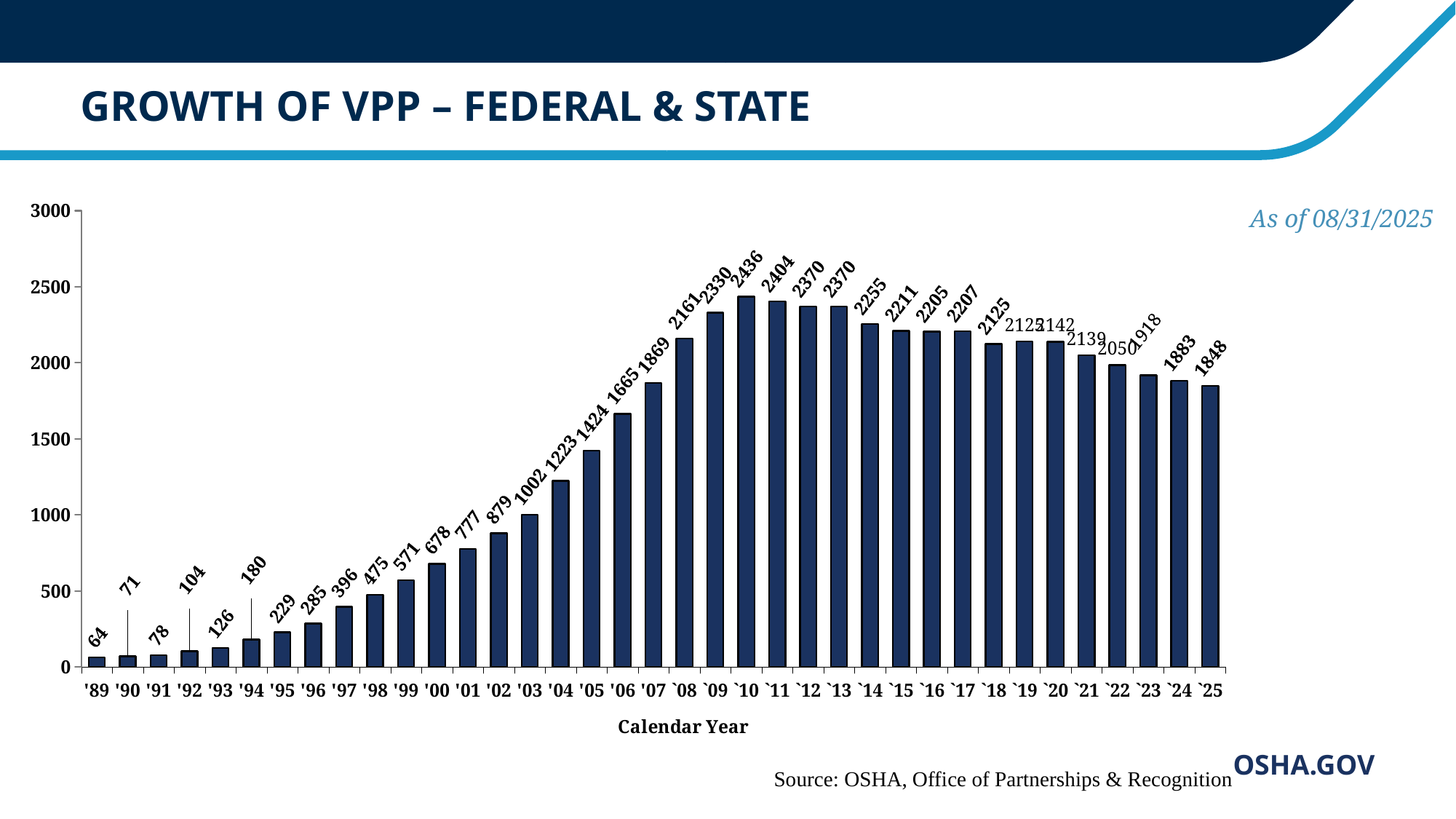
How many years are shown on the x axis? 37 Which year has the lowest value? '89 Which is larger, the value for '05 or the value for '06? '06 Which year has the highest value? '10 Is the value for '23 greater or less than 2000? less What is the value for '89? 64 What is the value for '10? 2436 Do the values rise or fall from '89 to '10? rise What is the value for '00? 678 What is the value for '17? 2207 What kind of chart is this? bar chart What is the difference between the values for '10 and '25? 588